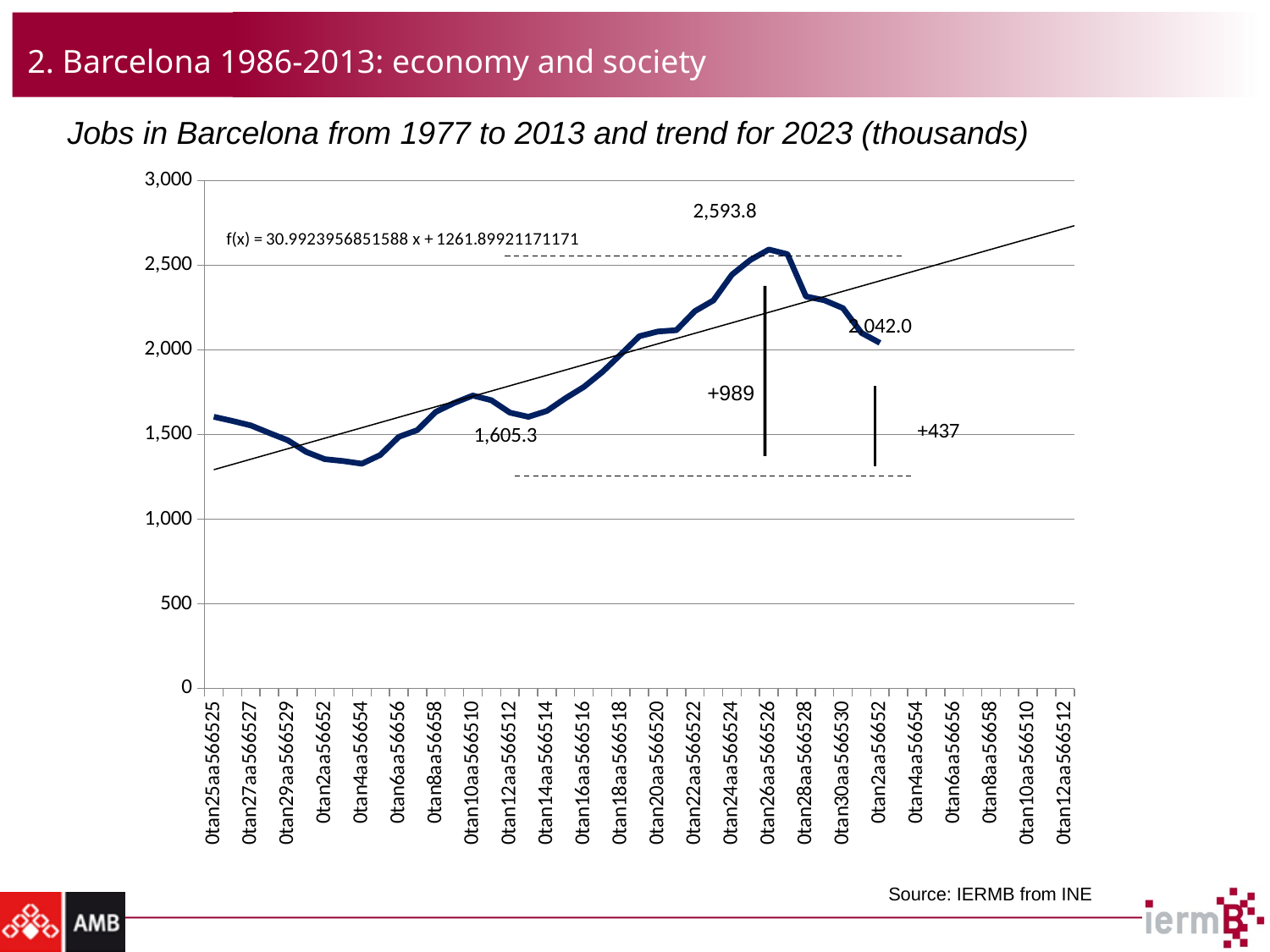
What is the difference between the peak value 2,593.8 and the labelled value 1,605.3? 988.5 Is the peak of the jobs line greater or less than 2,500? greater Does the straight trend line rise or fall from left to right? rises What is the equation of the trend line shown on the chart? f(x) = 30.9923956851588 x + 1261.89921171171 What value is labelled at the final plotted point of the jobs line? 2,042.0 Which is larger, the peak value of the jobs line or its final value? the peak value (2,593.8) What is the highest value shown on the vertical axis? 3,000 Is the lowest point of the jobs line greater or less than 1,500? less What is the highest value labelled on the jobs line? 2,593.8 What is the lower value labelled on the chart, near the dashed baseline? 1,605.3 What is the difference between the peak value 2,593.8 and the final value 2,042.0? 551.8 What kind of chart is shown on the slide? line chart